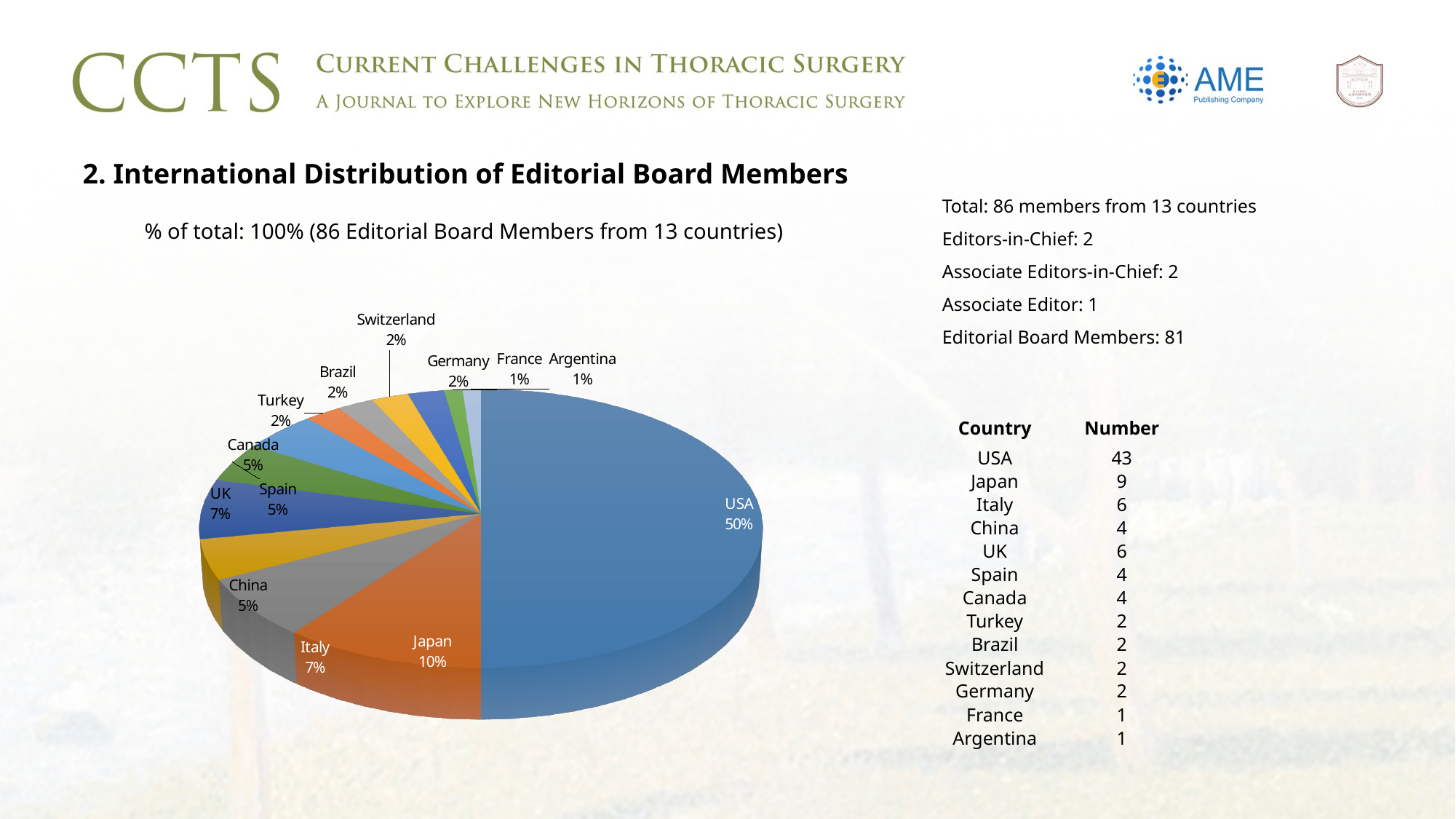
What is the value shown for Japan in the pie chart? 10% Which is larger in the pie chart, the slice for Japan or the slice for Italy? Japan What is the value shown for Switzerland in the pie chart? 2% What is the title of the pie chart? % of total: 100% (86 Editorial Board Members from 13 countries) What is the value shown for Italy in the pie chart? 7% What is the value shown for Canada in the pie chart? 5% Which country has the largest slice of the pie chart? USA How many countries (slices) are shown in the pie chart? 13 What kind of chart is shown on the slide? pie chart What share of the pie does USA hold? 50% What is the value shown for France in the pie chart? 1% What is the difference in percentage points between the USA slice and the Japan slice? 40